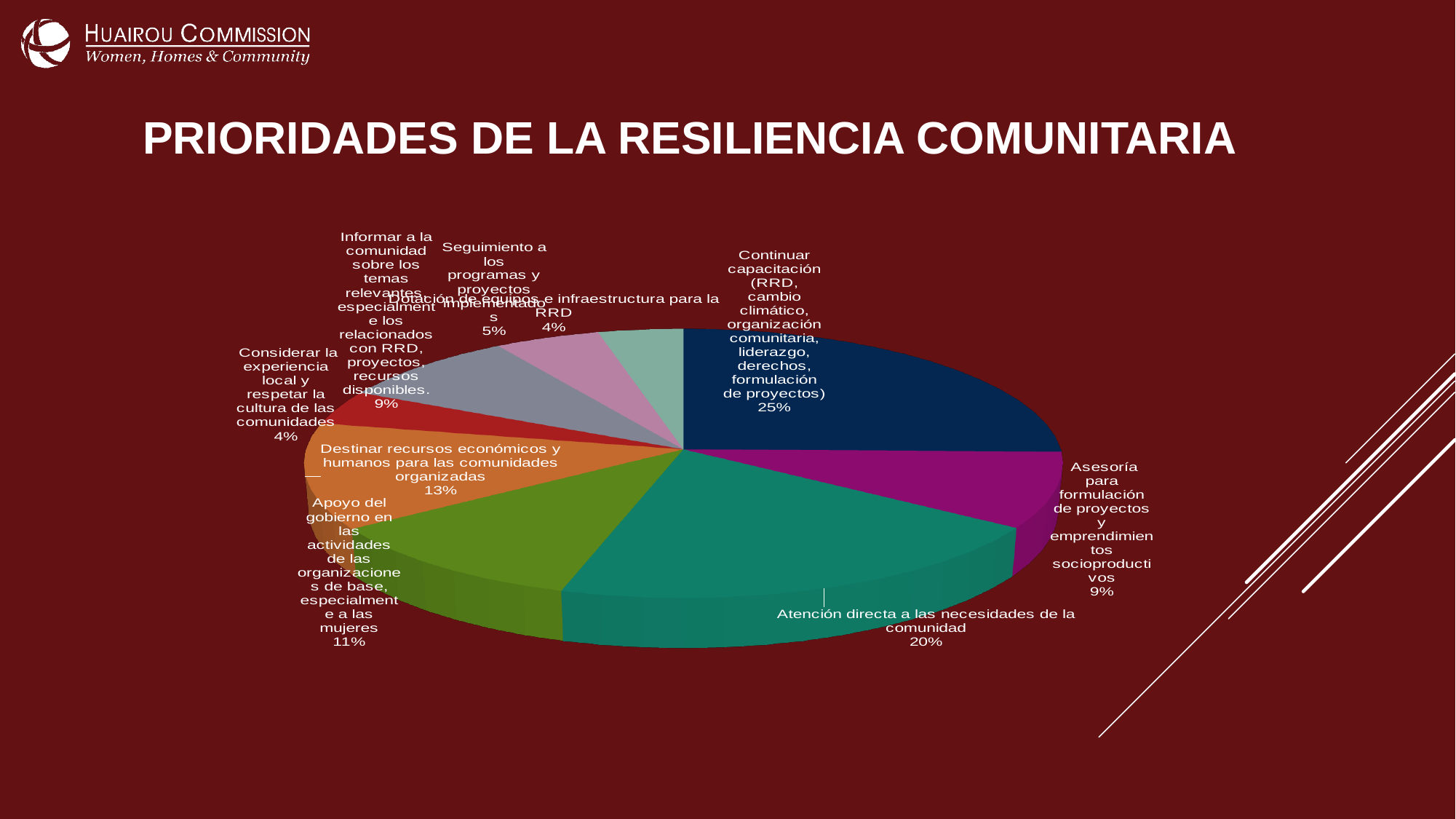
What percentage is shown for "Seguimiento a los programas y proyectos implementados"? 5% What percentage is shown for "Destinar recursos económicos y humanos para las comunidades organizadas"? 13% Which slice has the largest share of the pie? Continuar capacitación (RRD, cambio climático, organización comunitaria, liderazgo, derechos, formulación de proyectos) What kind of chart is shown on the slide? pie chart What share of the pie does "Asesoría para formulación de proyectos y emprendimientos socioproductivos" represent? 9% Which is larger: the share for "Destinar recursos económicos y humanos para las comunidades organizadas" or the share for "Apoyo del gobierno en las actividades de las organizaciones de base"? Destinar recursos económicos y humanos para las comunidades organizadas How many slices does the pie chart have? 9 What is the title of the slide containing the pie chart? PRIORIDADES DE LA RESILIENCIA COMUNITARIA What percentage is shown for "Apoyo del gobierno en las actividades de las organizaciones de base, especialmente a las mujeres"? 11% What percentage is shown for "Atención directa a las necesidades de la comunidad"? 20% What is the combined percentage of "Considerar la experiencia local y respetar la cultura de las comunidades" and "Dotación de equipos e infraestructura para la RRD"? 8% What is the difference in percentage points between "Continuar capacitación" and "Atención directa a las necesidades de la comunidad"? 5